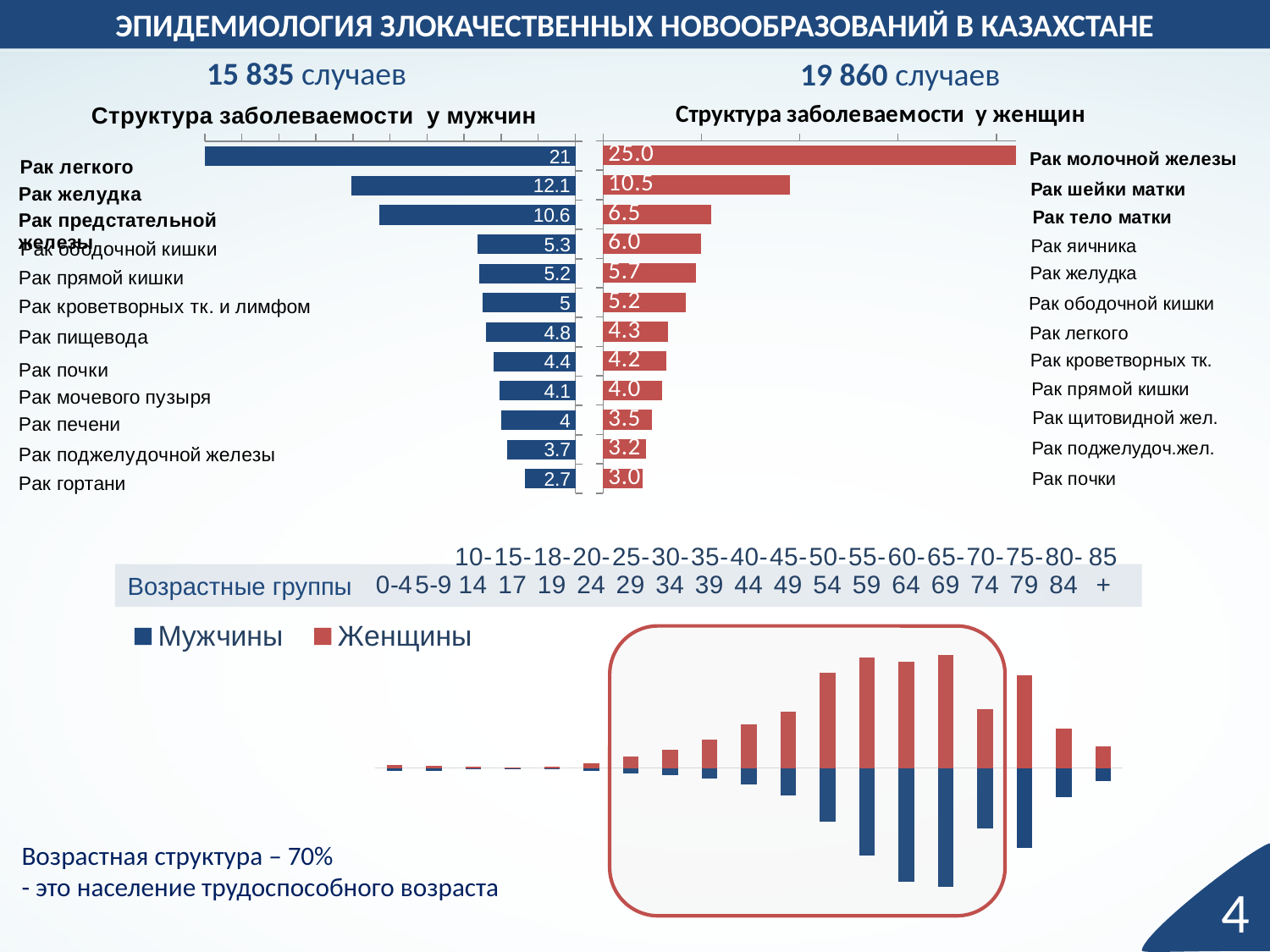
In the chart 'Структура заболеваемости у женщин', what is the value for Рак молочной железы? 25.0 In the chart 'Структура заболеваемости у женщин', what is the value for Рак шейки матки? 10.5 In the chart 'Структура заболеваемости у мужчин', what is the difference between Рак легкого and Рак желудка? 8.9 In the chart 'Структура заболеваемости у мужчин', what is the value for Рак желудка? 12.1 In the chart 'Структура заболеваемости у женщин', what is the difference between Рак тело матки and Рак почки? 3.5 How many series does the legend of the bottom age-group chart list? 2 In the chart 'Структура заболеваемости у мужчин', how many categories are shown? 12 In the chart 'Структура заболеваемости у мужчин', what is the value for Рак легкого? 21 What kind of chart is the bottom age-group chart? Bar chart In the chart 'Структура заболеваемости у женщин', which category has the highest value? Рак молочной железы In the chart 'Структура заболеваемости у мужчин', which category has the lowest value? Рак гортани In the chart 'Структура заболеваемости у женщин', which is larger: Рак яичника or Рак желудка? Рак яичника